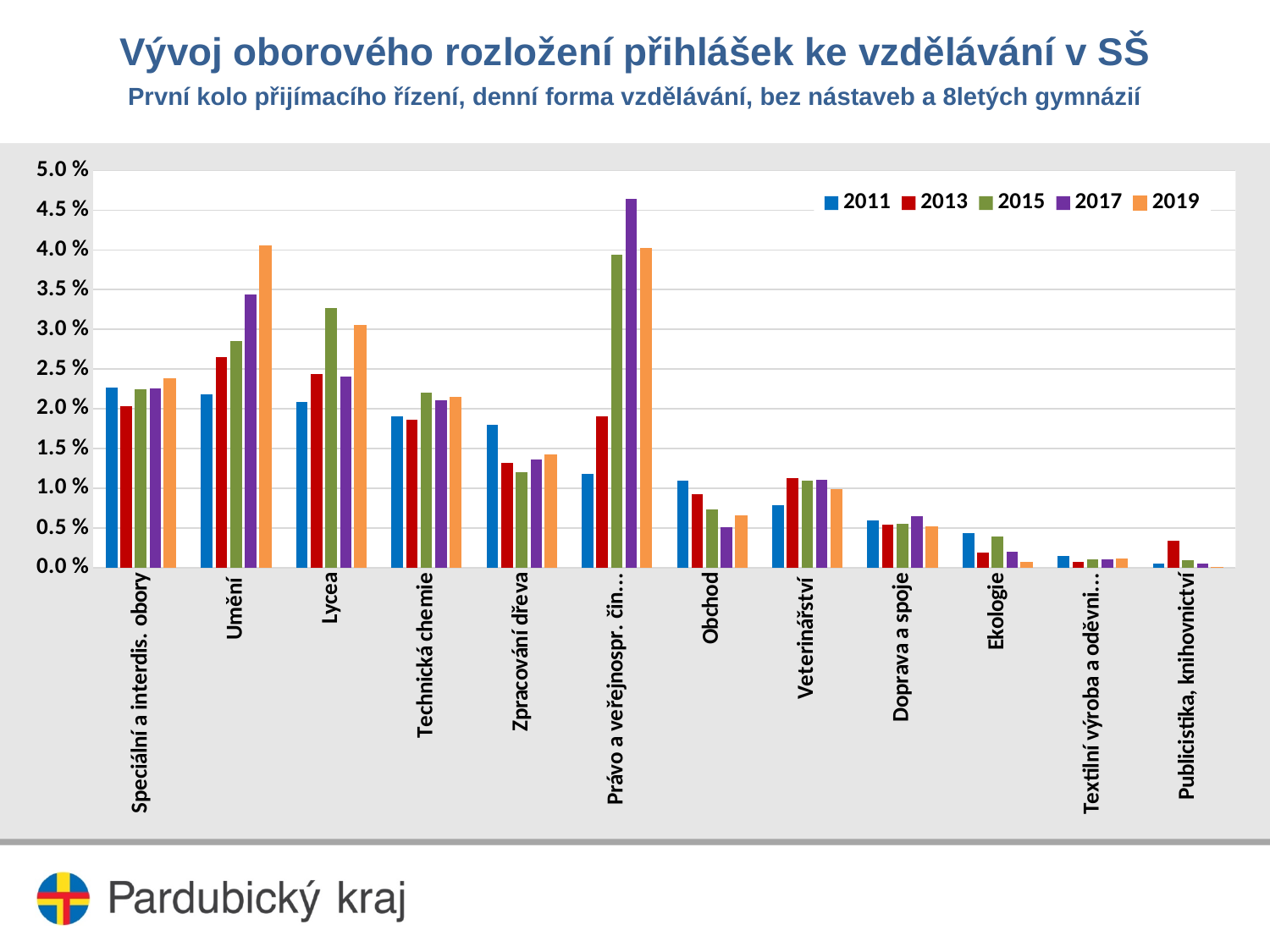
For Lycea, which year has the highest value? 2015 Which category has the tallest bar in the chart? Právo a veřejnospr. čin... For Umění, which year has the lowest value? 2011 Which years are listed in the legend? 2011, 2013, 2015, 2017, 2019 For Umění, which year has the highest value? 2019 Is the 2017 value for Umění greater or less than 3.0 %? greater Is the 2011 value for Veterinářství greater or less than 1.0 %? less How many categories are shown on the x axis? 12 What kind of chart is shown on the slide? bar chart Do the values for Umění rise or fall from 2011 to 2019? rise Which is larger for 2019: Umění or Lycea? Umění How many series does the legend list? 5